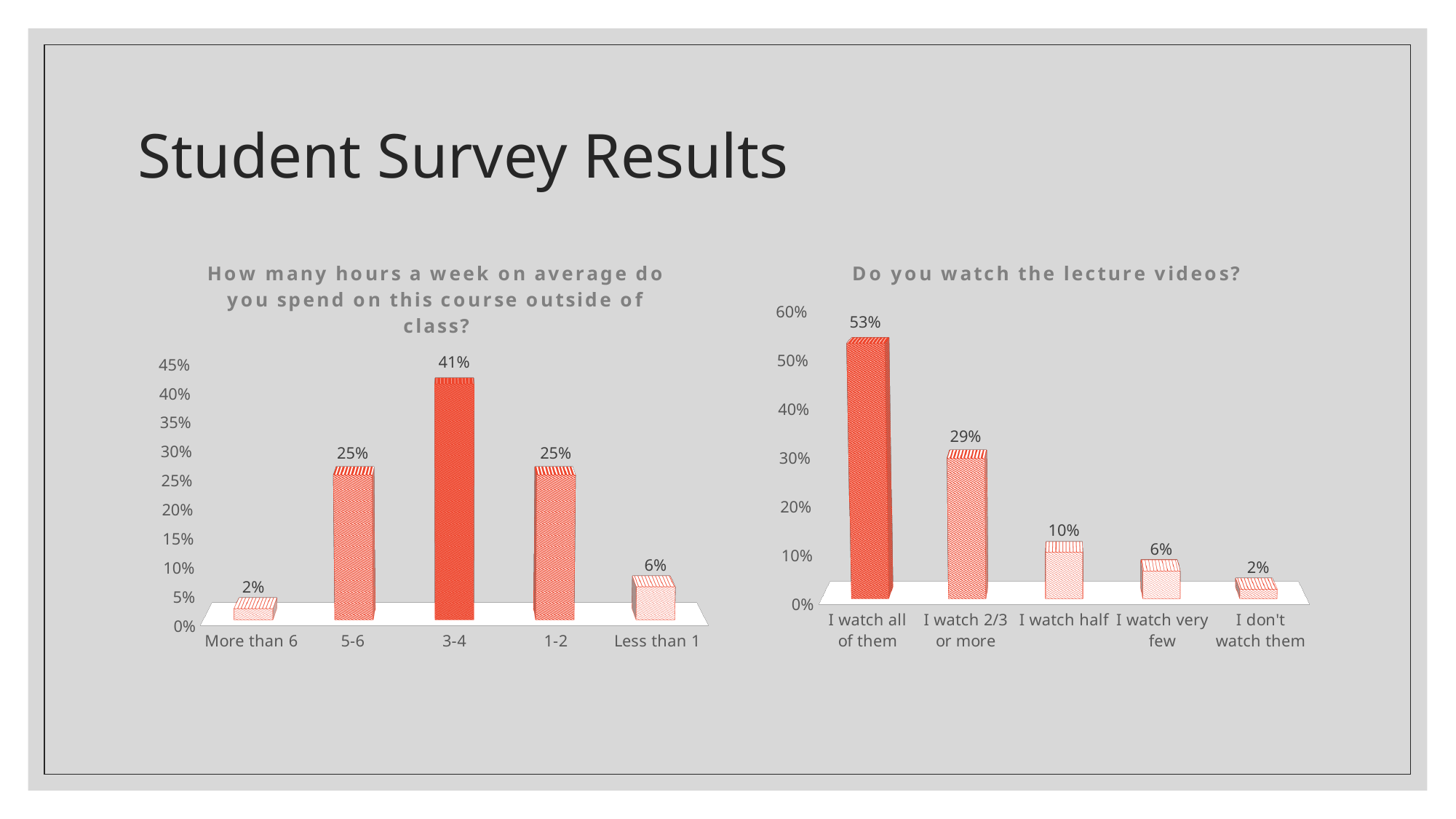
In the chart 'Do you watch the lecture videos?', which category has the highest value? I watch all of them In the chart 'Do you watch the lecture videos?', what is the difference between the values for 'I watch all of them' and 'I watch 2/3 or more'? 24% What is the title of the slide? Student Survey Results In the chart 'How many hours a week on average do you spend on this course outside of class?', which category has the lowest value? More than 6 In the chart 'How many hours a week on average do you spend on this course outside of class?', what is the value for 'Less than 1'? 6% In the chart 'How many hours a week on average do you spend on this course outside of class?', what is the value for '3-4'? 41% In the chart 'Do you watch the lecture videos?', do the values rise or fall from left to right along the x axis? fall In the chart 'How many hours a week on average do you spend on this course outside of class?', what is the difference between the values for '3-4' and '5-6'? 16% In the chart 'Do you watch the lecture videos?', which is larger, the value for 'I watch half' or the value for 'I watch very few'? I watch half In the chart 'Do you watch the lecture videos?', what is the value for 'I watch 2/3 or more'? 29% In the chart 'How many hours a week on average do you spend on this course outside of class?', how many categories are shown? 5 What kind of chart is the chart 'Do you watch the lecture videos?'? bar chart